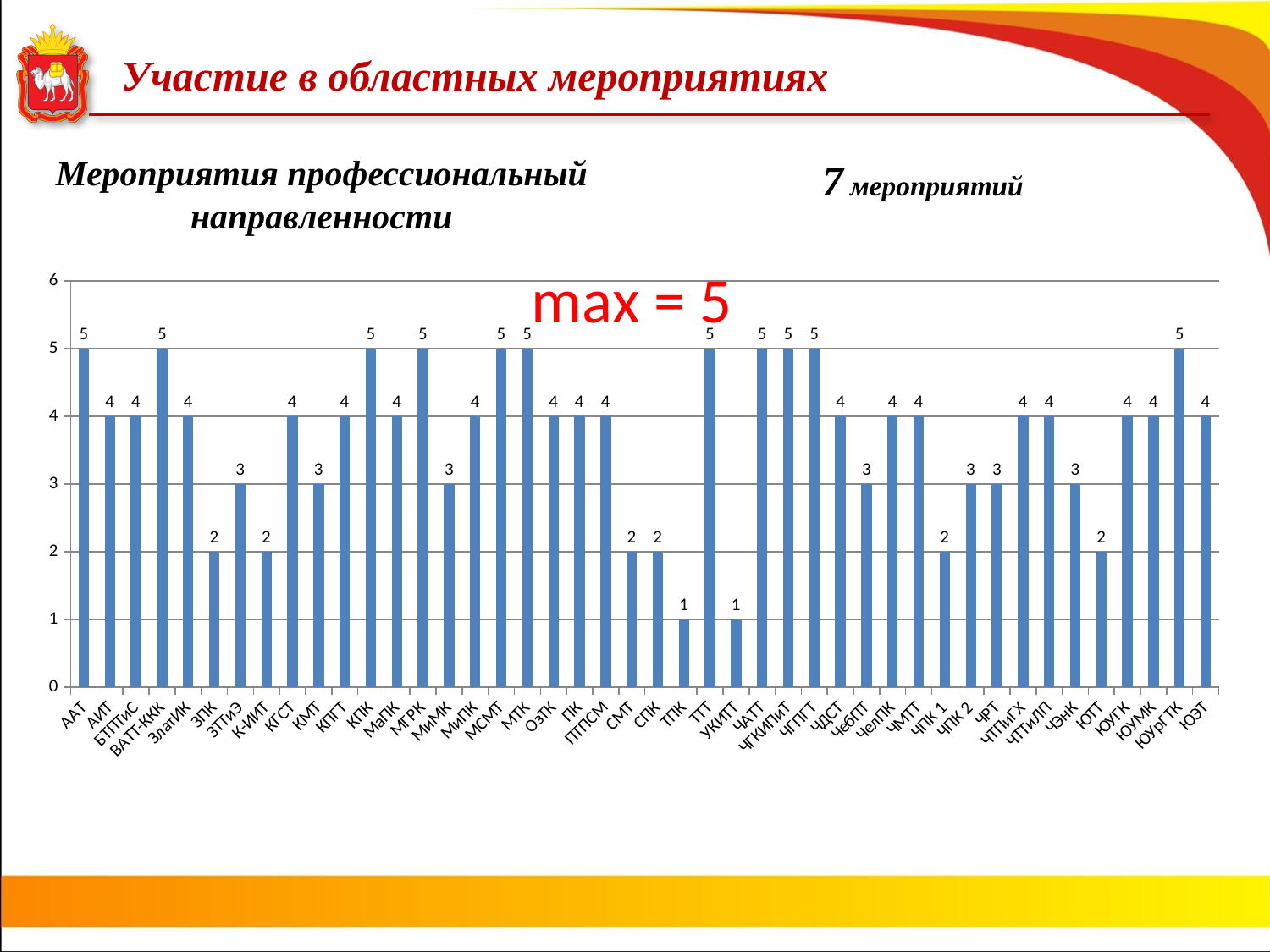
What kind of chart is shown on the slide? Bar chart What is the value for МГРК? 5 Which has a larger value, КМТ or КПК? КПК What is the highest value shown in the chart? 5 What is the value for ЧебПТ? 3 What is the value for ТПК? 1 Which has a larger value, СМТ or ЧДСТ? ЧДСТ What is the difference between the values for ААТ and ЗТТиЭ? 2 What maximum value is written in red text over the chart? max = 5 What is the lowest value shown in the chart? 1 What is the value for ЗПК? 2 What is the value for ЮЭТ? 4